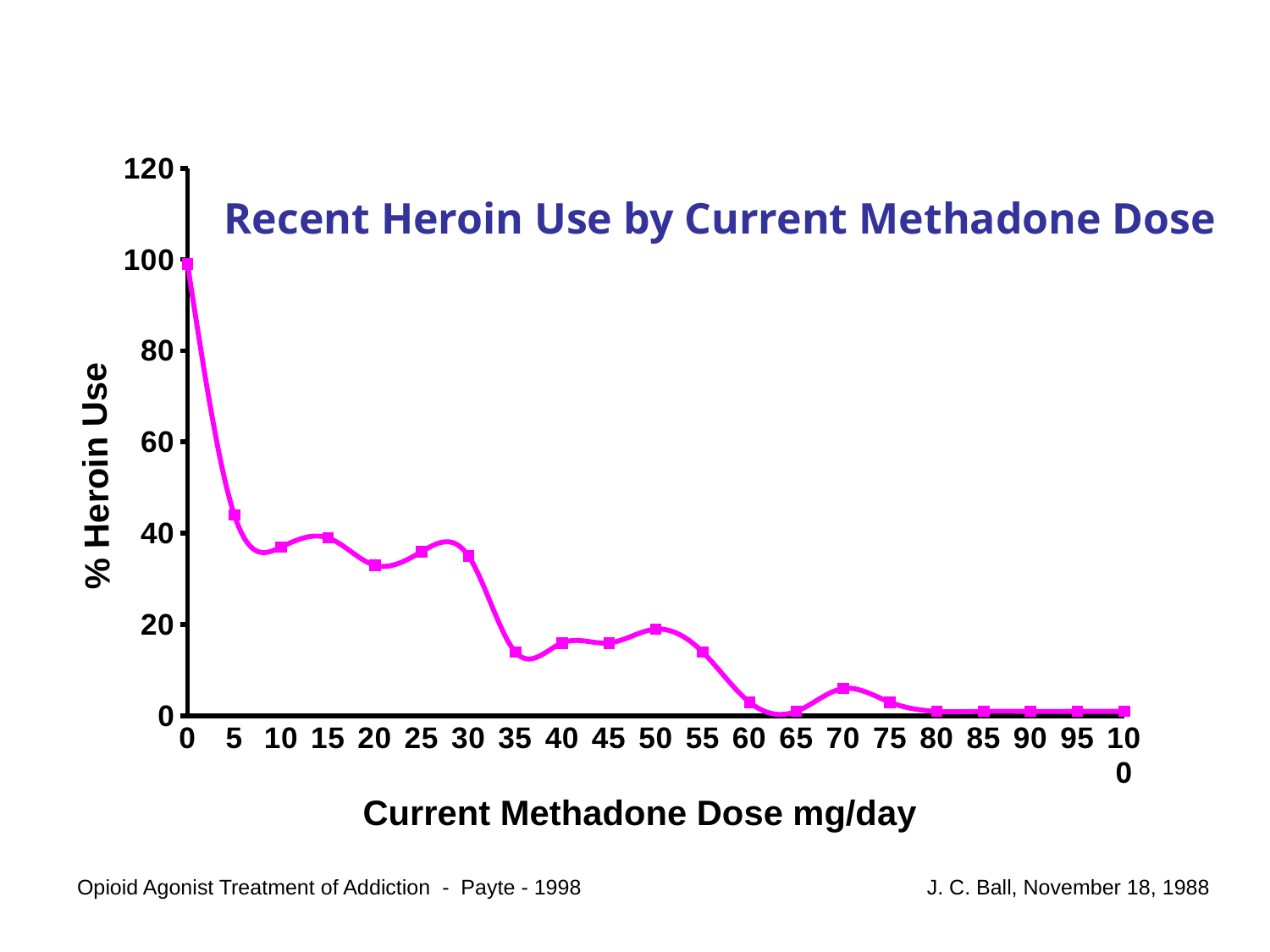
Which has the higher % heroin use, a dose of 5 mg/day or a dose of 35 mg/day? 5 mg/day What is the title of the chart? Recent Heroin Use by Current Methadone Dose Which has the higher % heroin use, a dose of 50 mg/day or a dose of 60 mg/day? 50 mg/day At which methadone dose is % heroin use highest? 0 Is the value for a dose of 0 mg/day greater or less than 80? greater Overall, does % heroin use rise or fall as the methadone dose increases? fall How many data points are plotted on the line? 21 What is the label of the x axis? Current Methadone Dose mg/day What kind of chart is shown on the slide? line chart Is the value for a dose of 5 mg/day greater or less than 40? greater Is the value for a dose of 35 mg/day greater or less than 20? less